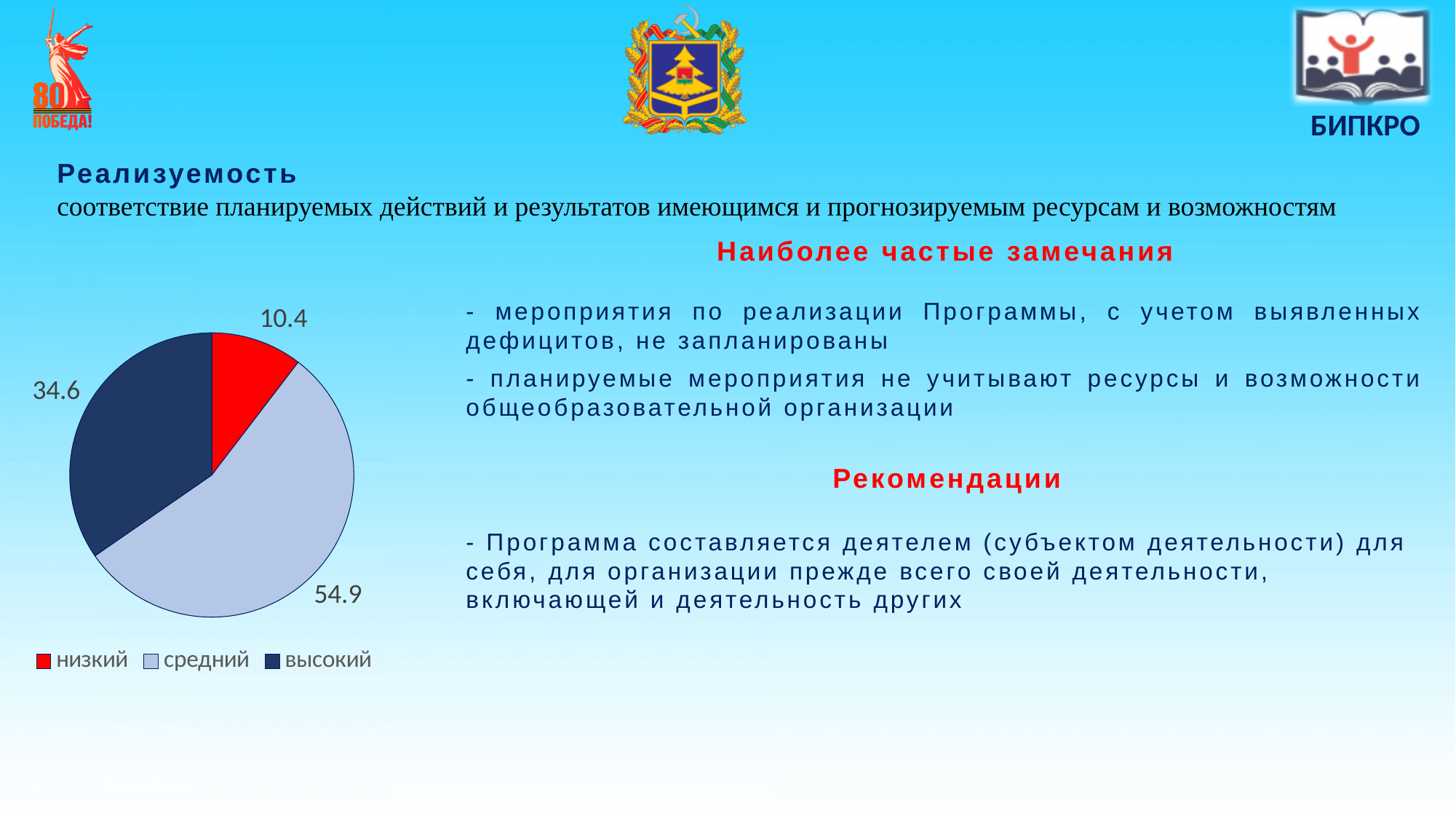
How many entries does the legend list? 3 What is the value for the 'средний' slice? 54.9 What is the difference between the 'средний' and 'высокий' values? 20.3 Which category has the largest slice? средний Which is larger, the 'высокий' slice or the 'низкий' slice? высокий What is the value for the 'высокий' slice? 34.6 What is the difference between the 'высокий' and 'низкий' values? 24.2 What colour is the 'низкий' slice? red Which category has the smallest slice? низкий What is the value for the 'низкий' slice? 10.4 How many slices does the pie chart have? 3 What kind of chart is shown on the slide? pie chart